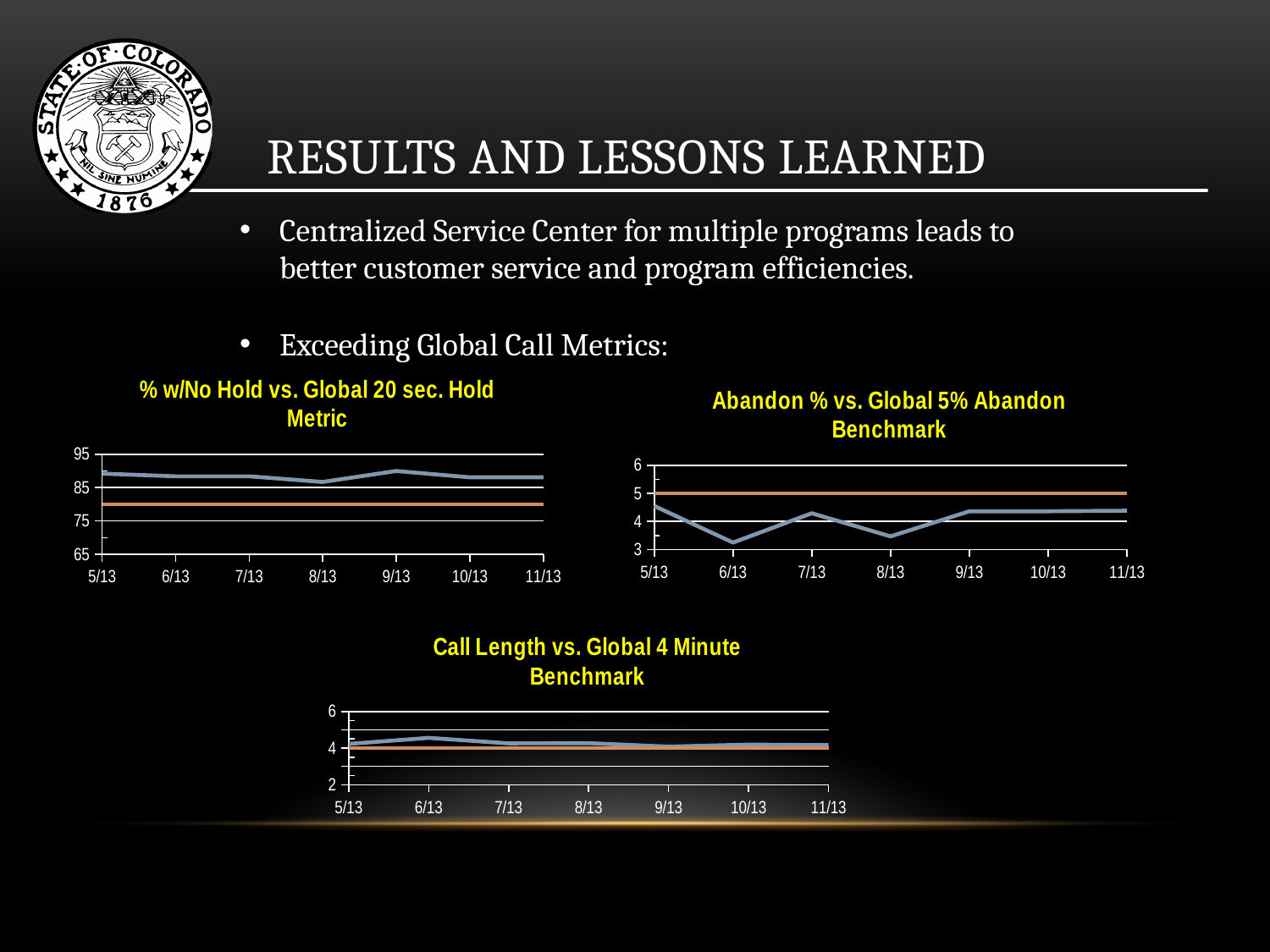
What type of chart is the '% w/No Hold vs. Global 20 sec. Hold Metric' chart? line chart In the 'Abandon % vs. Global 5% Abandon Benchmark' chart, is the abandon value for 5/13 greater or less than 4? greater In the '% w/No Hold vs. Global 20 sec. Hold Metric' chart, is the value for 8/13 greater or less than 85? greater In the 'Call Length vs. Global 4 Minute Benchmark' chart, which month has the highest call length? 6/13 What is the first month shown on the x axis of the 'Call Length vs. Global 4 Minute Benchmark' chart? 5/13 How many time points are plotted on the x axis of the 'Abandon % vs. Global 5% Abandon Benchmark' chart? 7 In the 'Abandon % vs. Global 5% Abandon Benchmark' chart, which month has the lowest abandon percentage? 6/13 What is the title of the chart at the bottom of the slide? Call Length vs. Global 4 Minute Benchmark In the '% w/No Hold vs. Global 20 sec. Hold Metric' chart, which month has the lowest % with no hold? 8/13 In the 'Call Length vs. Global 4 Minute Benchmark' chart, is the call length for 6/13 greater or less than 4? greater In the '% w/No Hold vs. Global 20 sec. Hold Metric' chart, is the value for 9/13 larger or smaller than the value for 8/13? larger